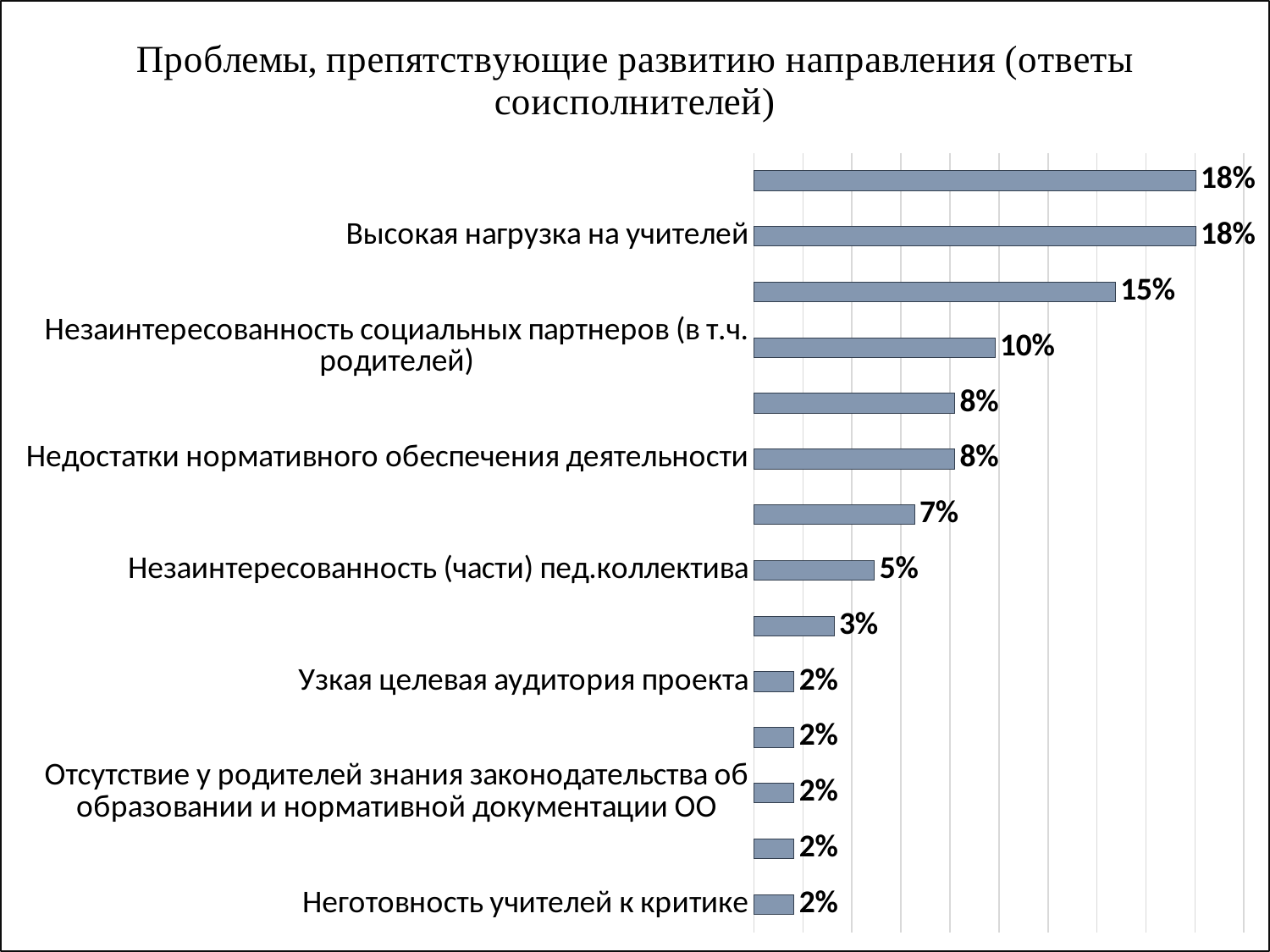
What is the value for "Незаинтересованность социальных партнеров (в т.ч. родителей)"? 10% What is the value for "Незаинтересованность (части) пед.коллектива"? 5% What is the value for "Неготовность учителей к критике"? 2% What type of chart is shown on the slide? Bar chart How many bars are plotted in the chart? 14 What is the value for "Высокая нагрузка на учителей"? 18% Which is larger: the value for "Недостатки нормативного обеспечения деятельности" or for "Незаинтересованность (части) пед.коллектива"? Недостатки нормативного обеспечения деятельности Do the bar values increase or decrease going from the top of the chart to the bottom? Decrease What is the title of the chart? Проблемы, препятствующие развитию направления (ответы соисполнителей) What is the value for "Узкая целевая аудитория проекта"? 2% What is the difference between the values for "Высокая нагрузка на учителей" and "Незаинтересованность социальных партнеров (в т.ч. родителей)"? 8 percentage points What is the value for "Недостатки нормативного обеспечения деятельности"? 8%